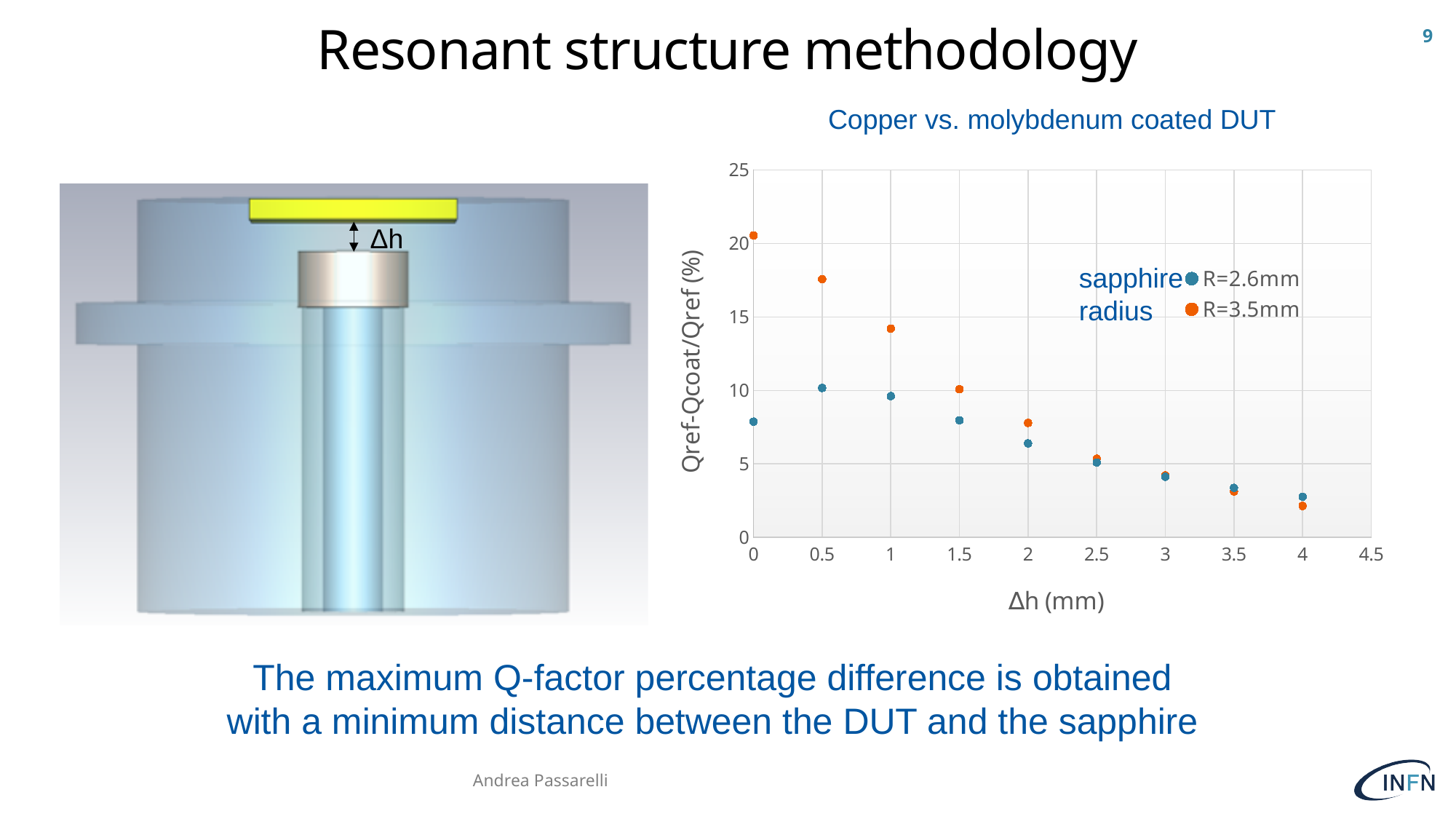
What is the title of the chart? Copper vs. molybdenum coated DUT Is the value for R=2.6mm at Δh = 0 mm greater or less than 10? less Is the value for R=3.5mm at Δh = 0 mm greater or less than 20? greater At which Δh value does the R=2.6mm series reach its highest value? 0.5 How many series does the chart legend list? 2 How many data points are plotted for the R=3.5mm series? 9 Is the value for R=3.5mm at Δh = 2 mm greater or less than 10? less What kind of chart is shown on the slide? Scatter chart At Δh = 1 mm, which series has the higher value, R=2.6mm or R=3.5mm? R=3.5mm At which Δh value does the R=3.5mm series reach its highest value? 0 What are the two series named in the chart legend? R=2.6mm and R=3.5mm